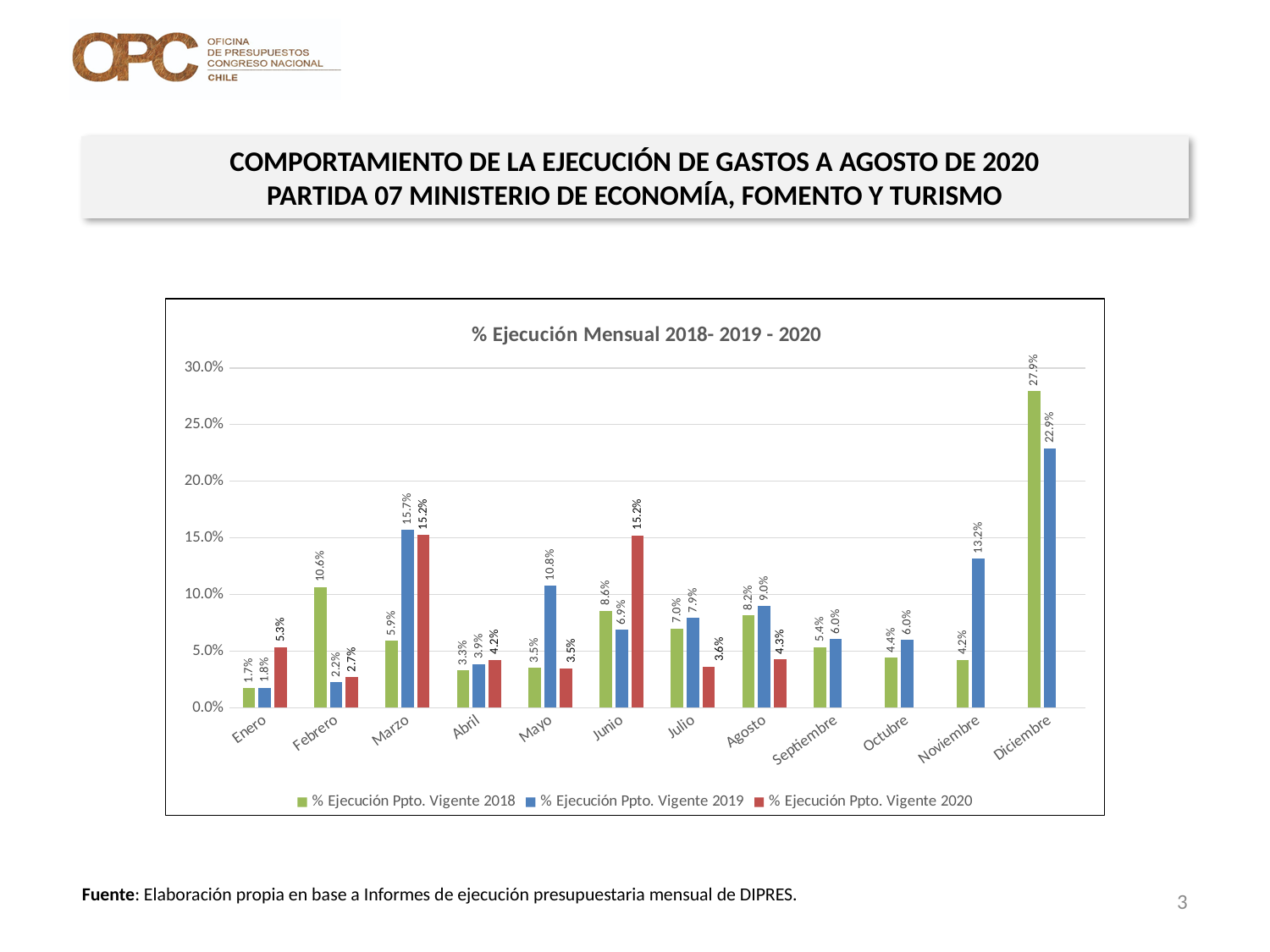
Is the value for % Ejecución Ppto. Vigente 2019 in Mayo greater or less than 10.0%? greater What is the difference between the 2018 and 2019 values in Diciembre? 5.0% What is the value for % Ejecución Ppto. Vigente 2020 in Junio? 15.2% What is the value for % Ejecución Ppto. Vigente 2018 in Febrero? 10.6% Which is larger in Marzo: the 2019 value or the 2020 value? 2019 value What is the value for % Ejecución Ppto. Vigente 2019 in Noviembre? 13.2% How many months are shown on the x axis? 12 What is the title of the chart? % Ejecución Mensual 2018- 2019 - 2020 What kind of chart is shown on the slide? Bar chart Which month has the highest value for % Ejecución Ppto. Vigente 2018? Diciembre Which month has the lowest value for % Ejecución Ppto. Vigente 2019? Enero How many series does the legend list? 3